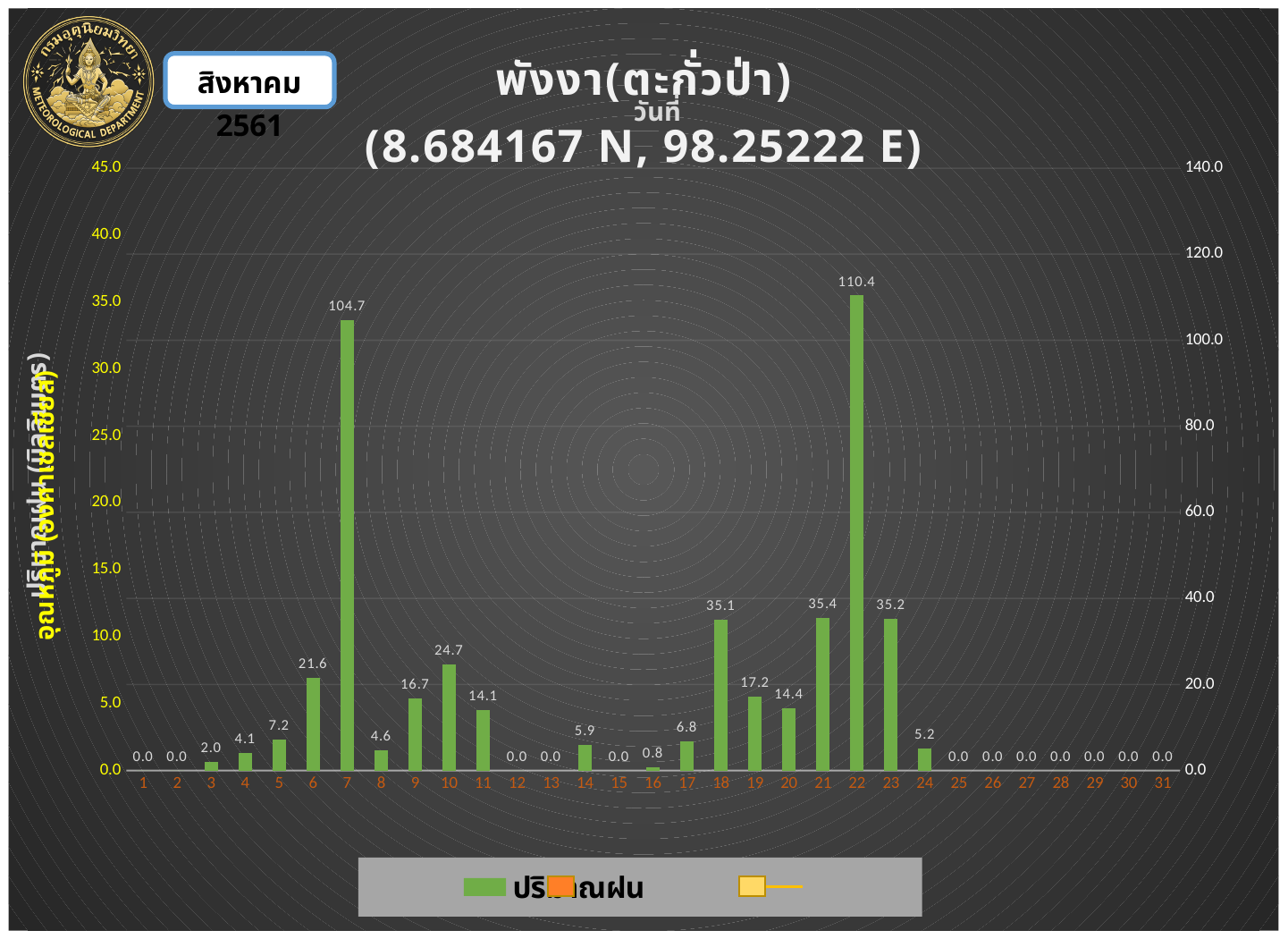
What is the rainfall value shown for day 16? 0.8 What is the rainfall value shown for day 10? 24.7 What is the rainfall value shown for day 7? 104.7 What is the rainfall value shown for day 22? 110.4 What is the difference between the rainfall values for day 22 and day 7? 5.7 Which day has the larger rainfall value, day 18 or day 10? day 18 What is the label of the green bar series in the legend? ปริมาณฝน How many days show a rainfall value of 0.0? 12 What kind of chart is used to show the rainfall data? bar chart How many days are shown on the x axis of the chart? 31 Which day has the highest rainfall bar? 22 What is the difference between the rainfall values for day 21 and day 19? 18.2